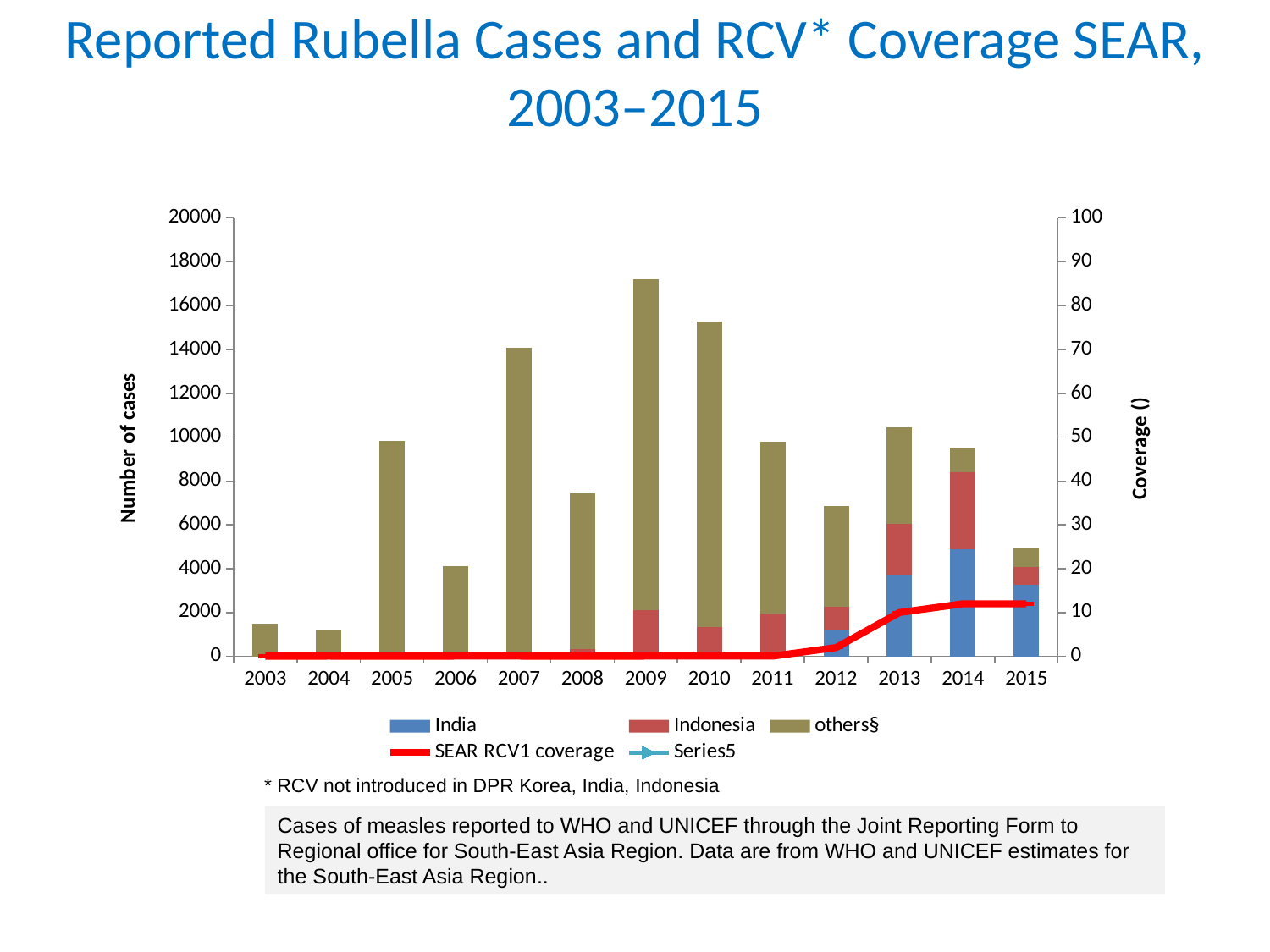
Which series is shown in blue in the stacked bars? India Does the SEAR RCV1 coverage line rise or fall between 2011 and 2014? rise Which year has more total reported cases, 2007 or 2010? 2010 How many years are shown on the x axis? 13 What kind of chart is used to show the number of rubella cases? bar chart Is the total number of cases in 2004 greater or less than 2000? less Which year has the lowest total number of reported rubella cases? 2004 Is the total number of cases in 2007 greater or less than 12000? greater Is the total number of cases in 2006 greater or less than 6000? less Which year has the highest total number of reported rubella cases? 2009 How many entries does the legend list? 5